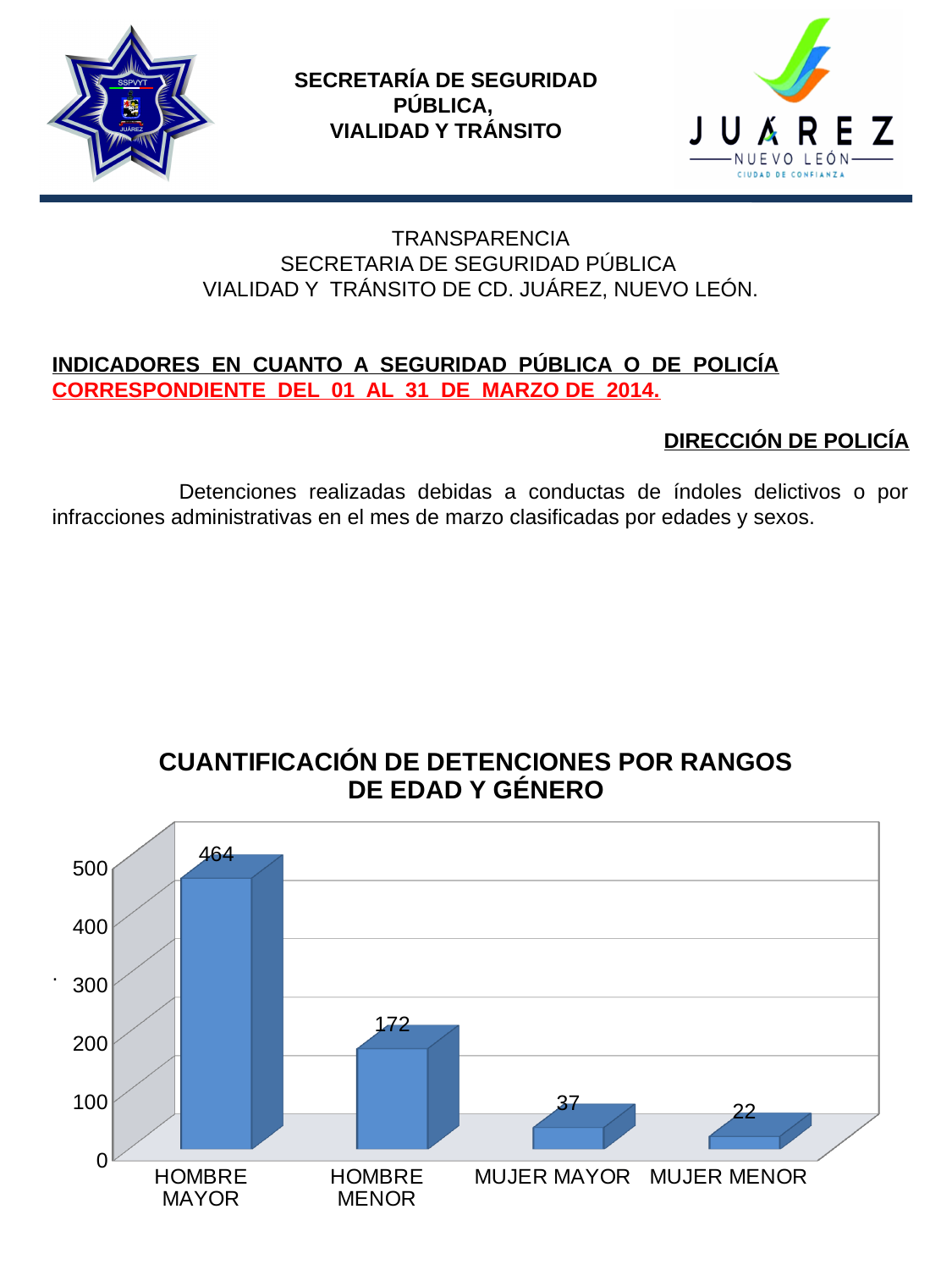
What is the value for MUJER MENOR? 22 Which is larger, the value for HOMBRE MENOR or the value for MUJER MAYOR? HOMBRE MENOR Which category has the highest value? HOMBRE MAYOR What is the title of the chart? CUANTIFICACIÓN DE DETENCIONES POR RANGOS DE EDAD Y GÉNERO What is the difference between the values for HOMBRE MAYOR and HOMBRE MENOR? 292 What kind of chart is shown on the slide? bar chart What is the value for HOMBRE MENOR? 172 What is the difference between the values for MUJER MAYOR and MUJER MENOR? 15 What is the value for MUJER MAYOR? 37 How many categories are shown on the chart? 4 Which category has the lowest value? MUJER MENOR What is the value for HOMBRE MAYOR? 464